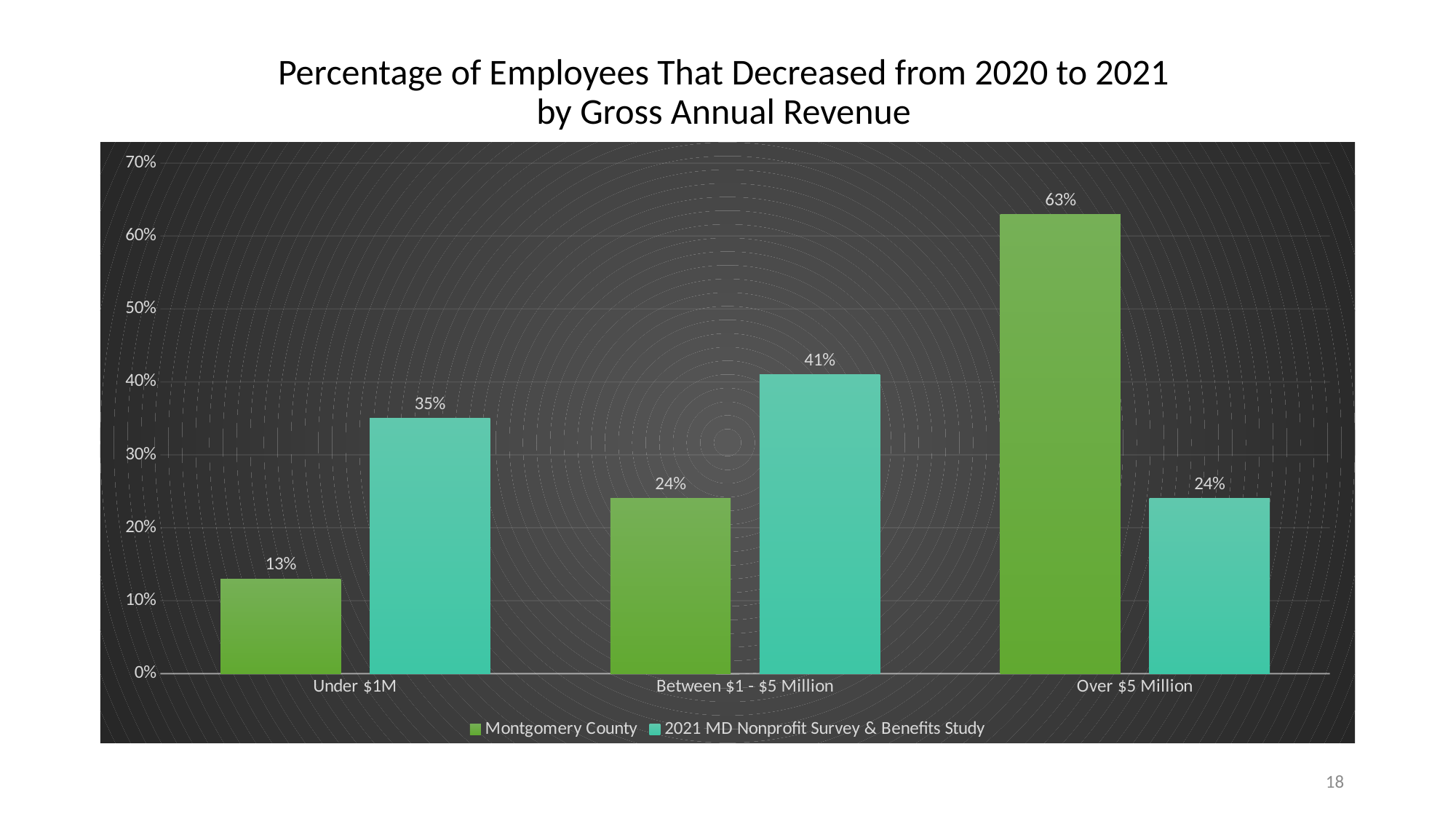
What is the difference between the Montgomery County and 2021 MD Nonprofit Survey & Benefits Study values for Under $1M? 22% Which revenue category has the lowest 2021 MD Nonprofit Survey & Benefits Study value? Over $5 Million What is the Montgomery County value for Over $5 Million? 63% Which revenue category has the highest Montgomery County value? Over $5 Million How many revenue categories are shown on the x axis? 3 What is the 2021 MD Nonprofit Survey & Benefits Study value for Over $5 Million? 24% Do the Montgomery County values rise or fall as revenue increases along the x axis? Rise What is the Montgomery County value for Under $1M? 13% What kind of chart is shown on the slide? Bar chart How many series does the legend list? 2 What is the 2021 MD Nonprofit Survey & Benefits Study value for Between $1 - $5 Million? 41% For Between $1 - $5 Million, which series has the larger value: Montgomery County or 2021 MD Nonprofit Survey & Benefits Study? 2021 MD Nonprofit Survey & Benefits Study